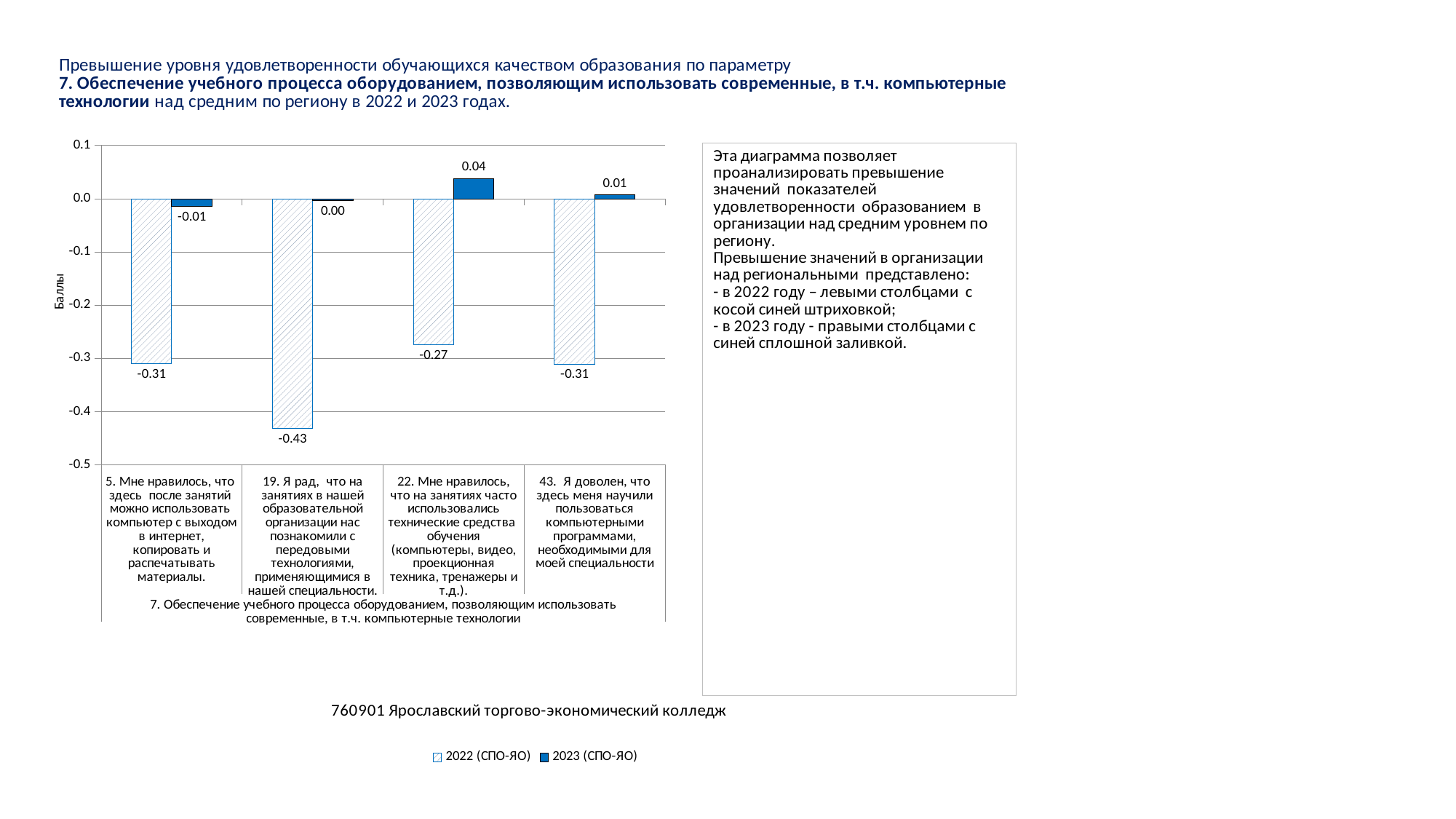
How many categories are shown on the x axis of the chart? 4 What is the 2023 (СПО-ЯО) value for category 5 ("Мне нравилось, что здесь после занятий можно использовать компьютер с выходом в интернет...")? -0.01 What is the 2022 (СПО-ЯО) value for category 43 ("Я доволен, что здесь меня научили пользоваться компьютерными программами...")? -0.31 How many series does the chart legend list? 2 Which category has the lowest 2022 (СПО-ЯО) value? 19. Я рад, что на занятиях в нашей образовательной организации нас познакомили с передовыми технологиями, применяющимися в нашей специальности. What is the 2023 (СПО-ЯО) value for category 22 ("Мне нравилось, что на занятиях часто использовались технические средства обучения...")? 0.04 Which is larger for category 5: the 2022 (СПО-ЯО) value or the 2023 (СПО-ЯО) value? 2023 (СПО-ЯО) What is the 2022 (СПО-ЯО) value for category 19 ("Я рад, что на занятиях в нашей образовательной организации нас познакомили с передовыми технологиями...")? -0.43 What type of chart is shown on the slide? Bar chart Which category has the highest 2023 (СПО-ЯО) value? 22. Мне нравилось, что на занятиях часто использовались технические средства обучения (компьютеры, видео, проекционная техника, тренажеры и т.д.). What is the difference between the 2023 and 2022 values for category 22? 0.31 What is the label of the vertical axis of the chart? Баллы